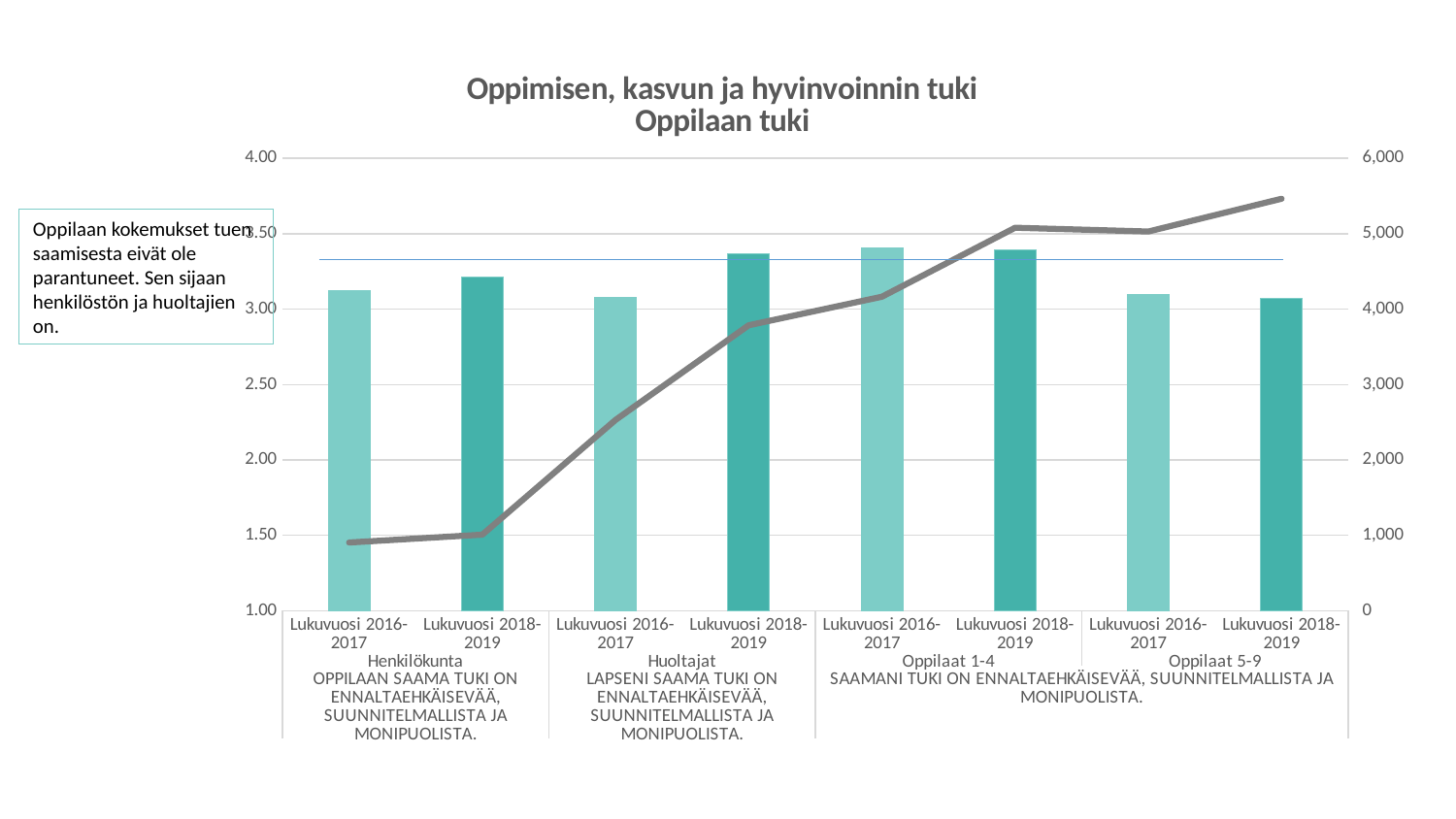
How many bars are plotted in the chart? 8 Is the last point of the grey line (Oppilaat 5-9, Lukuvuosi 2018-2019) greater or less than 5,000 on the right axis? greater Is the bar for Henkilökunta, Lukuvuosi 2016-2017 greater or less than 3.00 on the left axis? greater Is the bar for Huoltajat, Lukuvuosi 2018-2019 greater or less than 3.50 on the left axis? less For Lukuvuosi 2018-2019, which group has the taller bar: Oppilaat 1-4 or Oppilaat 5-9? Oppilaat 1-4 Does the grey line rise or fall from left to right across the chart? It rises What kind of chart is shown on the slide? A combined bar and line chart What is the title of the chart? Oppimisen, kasvun ja hyvinvoinnin tuki Oppilaan tuki Which bar is taller for Huoltajat: Lukuvuosi 2016-2017 or Lukuvuosi 2018-2019? Lukuvuosi 2018-2019 How many respondent groups (Henkilökunta, Huoltajat, Oppilaat 1-4, Oppilaat 5-9) are shown on the x axis? 4 Which bar is taller for Henkilökunta: Lukuvuosi 2016-2017 or Lukuvuosi 2018-2019? Lukuvuosi 2018-2019